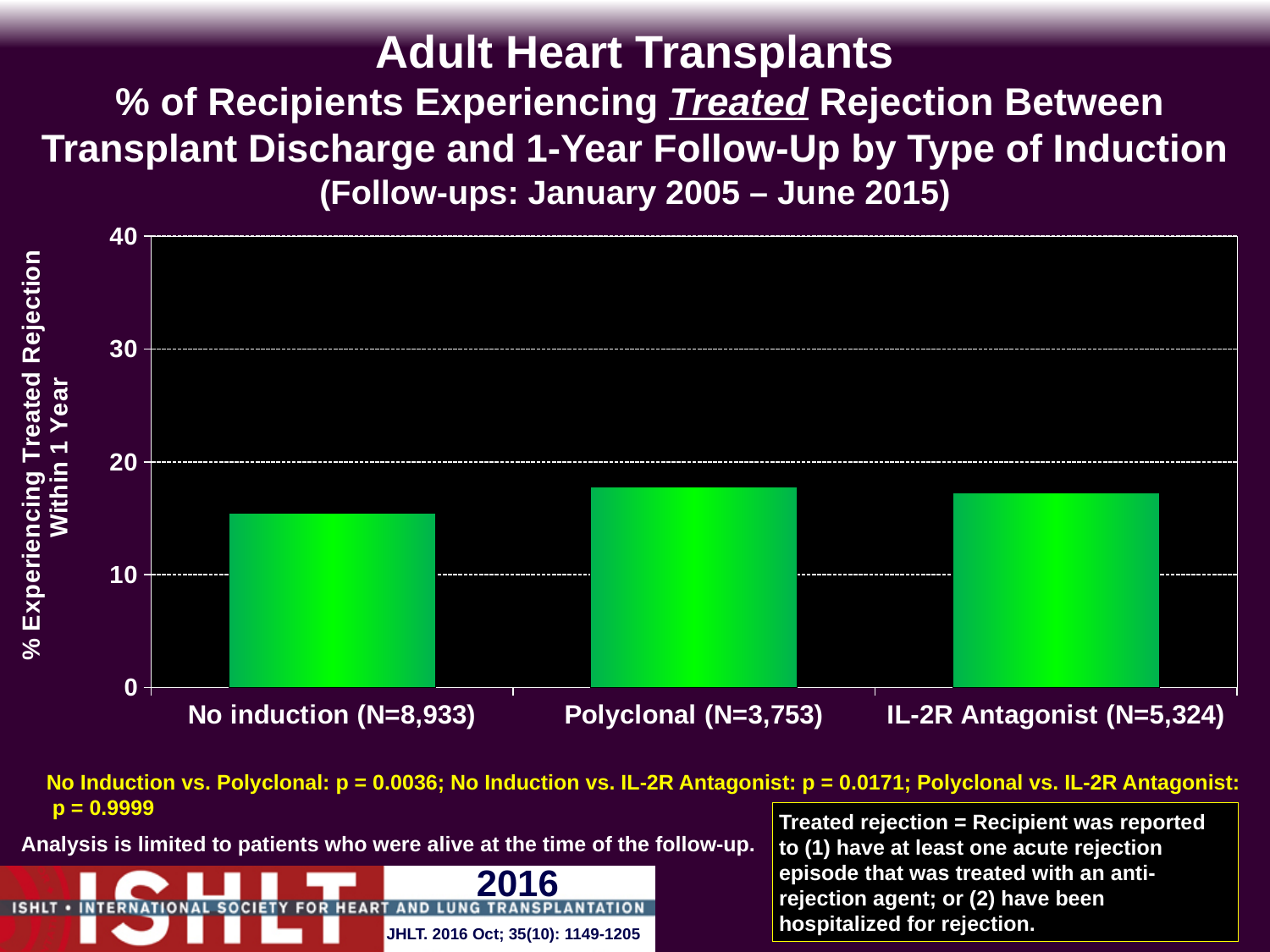
Which is larger, the value for No induction (N=8,933) or the value for IL-2R Antagonist (N=5,324)? IL-2R Antagonist (N=5,324) Is the value for IL-2R Antagonist (N=5,324) greater or less than 20? less What is the maximum value shown on the y axis of the chart? 40 How many induction-type categories are plotted on the chart? 3 Which is larger, the value for No induction (N=8,933) or the value for Polyclonal (N=3,753)? Polyclonal (N=3,753) Is the value for No induction (N=8,933) greater or less than 20? less What is the y-axis label of the chart? % Experiencing Treated Rejection Within 1 Year Is the value for No induction (N=8,933) greater or less than 10? greater Which induction type has the lowest % experiencing treated rejection within 1 year? No induction (N=8,933) What is the N for the Polyclonal category? 3,753 What kind of chart is shown on the slide? bar chart